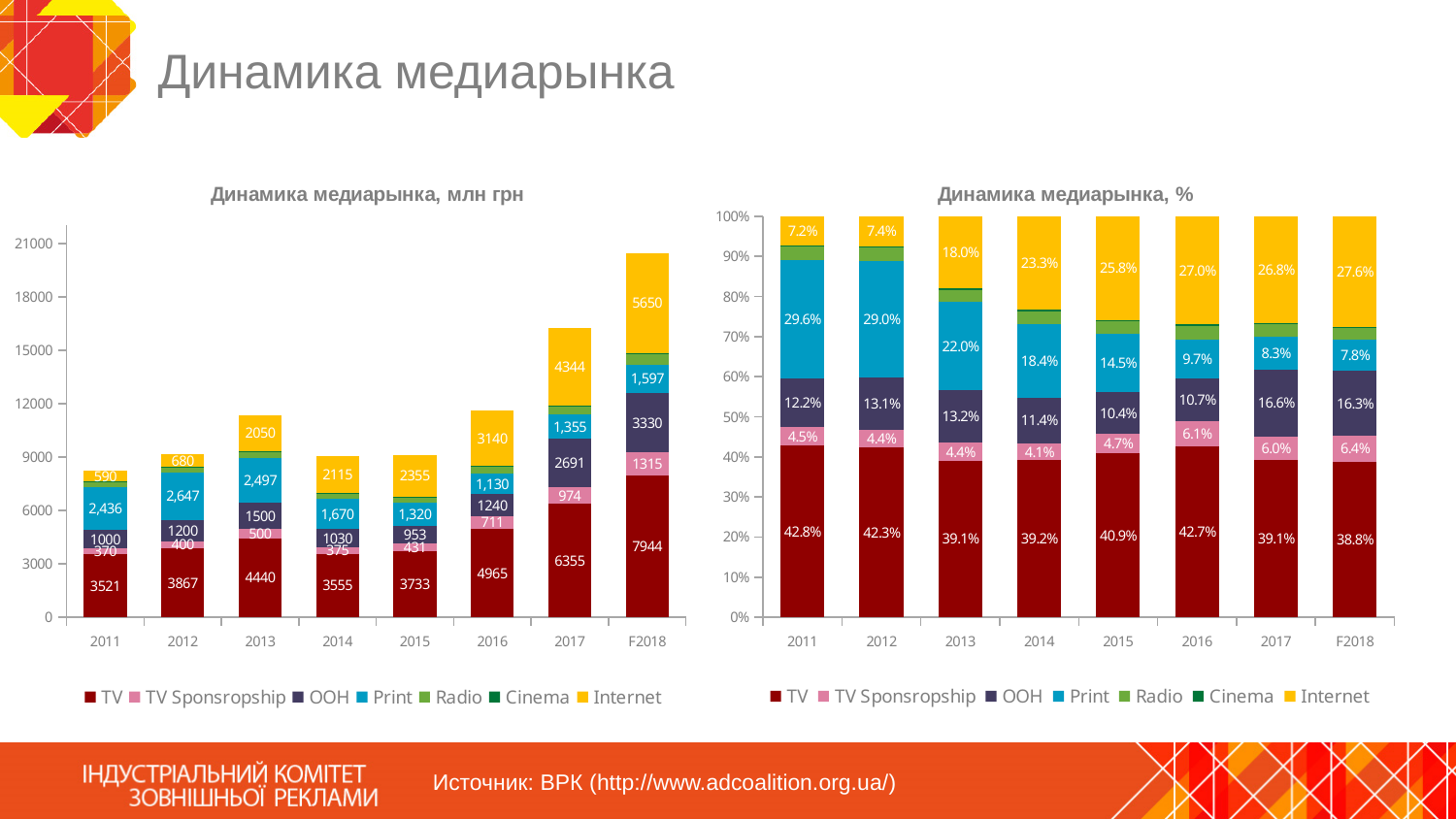
In the chart 'Динамика медиарынка, млн грн', in which year is the TV value the lowest? 2011 In the chart 'Динамика медиарынка, млн грн', what is the value for TV in 2013? 4440 How many series does the legend of the chart 'Динамика медиарынка, %' list? 7 What kind of chart is 'Динамика медиарынка, %'? Stacked bar chart In the chart 'Динамика медиарынка, млн грн', is the total height of the 2017 stacked bar greater or less than 15000? greater In the chart 'Динамика медиарынка, млн грн', what is the difference between the Internet values for F2018 and 2017? 1306 In the chart 'Динамика медиарынка, %', does the Print share rise or fall from 2011 to F2018? Fall In the chart 'Динамика медиарынка, млн грн', what is the Internet value for F2018? 5650 In the chart 'Динамика медиарынка, млн грн', which is larger in 2016: the Print value or the OOH value? OOH How many years (categories) are shown on the x axis of the chart 'Динамика медиарынка, %'? 8 In the chart 'Динамика медиарынка, млн грн', in which year is the Internet value the highest? F2018 In the chart 'Динамика медиарынка, %', what is the Print share in 2015? 14.5%